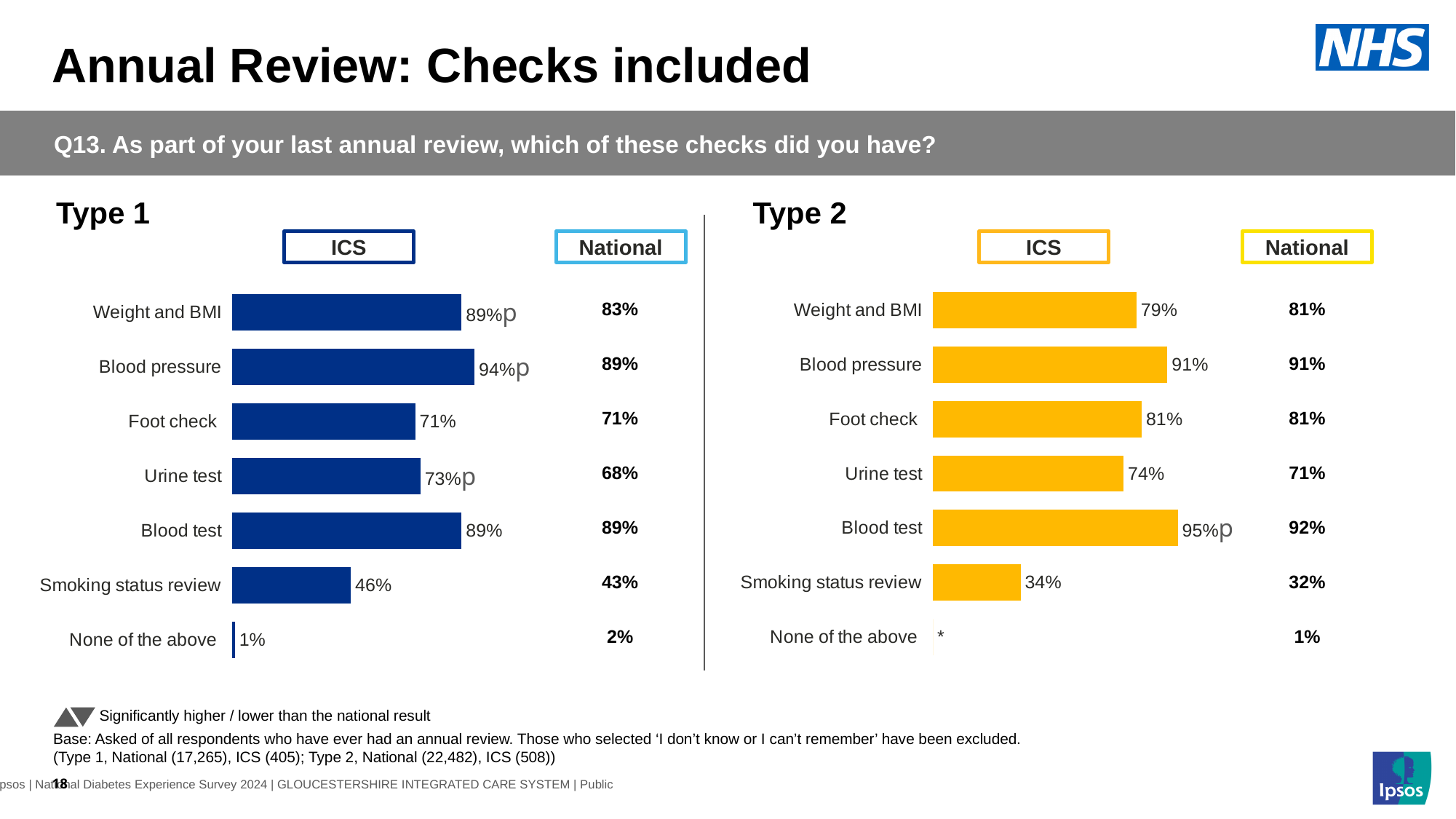
In the Type 1 chart, which is larger: the ICS value for Foot check or the ICS value for Smoking status review? Foot check In the Type 2 chart, what is the National value for Blood test? 92% In the Type 2 chart, is the ICS value for Weight and BMI higher or lower than the National value? lower How many checks are listed in the Type 1 chart? 7 In the Type 1 chart, what is the National value for Urine test? 68% In the Type 1 chart, which check has the highest ICS value? Blood pressure In the Type 1 chart, what is the ICS value for Blood pressure? 94% What type of chart is used to show the ICS values in the Type 2 chart? bar chart In the Type 2 chart, which check has the lowest ICS value among those with a printed percentage? Smoking status review In the Type 2 chart, what is the difference between the ICS values for Blood test and Urine test? 21 percentage points In the Type 2 chart, what is the ICS value for Smoking status review? 34% In the Type 1 chart, what is the difference between the ICS and National values for Weight and BMI? 6 percentage points